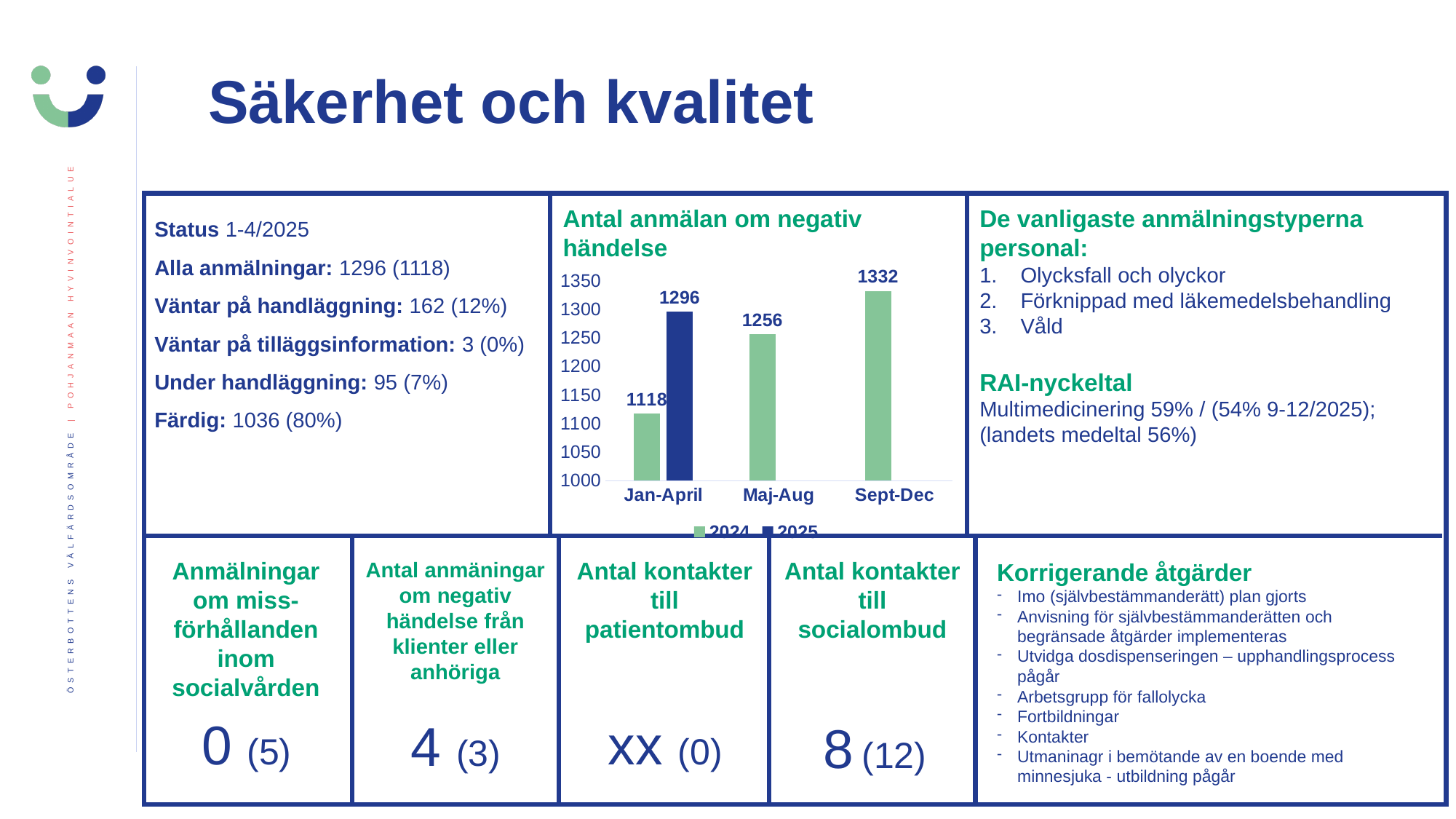
In the chart "Antal anmälan om negativ händelse", what is the difference between the 2025 and 2024 values for Jan-April? 178 How many periods are shown on the x axis of the chart "Antal anmälan om negativ händelse"? 3 How many series does the legend of the chart "Antal anmälan om negativ händelse" list? 2 In the chart "Antal anmälan om negativ händelse", what is the 2024 value for Maj-Aug? 1256 In the chart "Antal anmälan om negativ händelse", which period has the highest 2024 value? Sept-Dec In the chart "Antal anmälan om negativ händelse", which period has the lowest 2024 value? Jan-April What kind of chart is "Antal anmälan om negativ händelse"? bar chart In the chart "Antal anmälan om negativ händelse", what is the 2024 value for Jan-April? 1118 In the chart "Antal anmälan om negativ händelse", which is larger for Jan-April: the 2024 value or the 2025 value? 2025 In the chart "Antal anmälan om negativ händelse", what is the 2025 value for Jan-April? 1296 In the chart "Antal anmälan om negativ händelse", what is the 2024 value for Sept-Dec? 1332 In the chart "Antal anmälan om negativ händelse", do the 2024 values rise or fall from Jan-April to Sept-Dec? rise